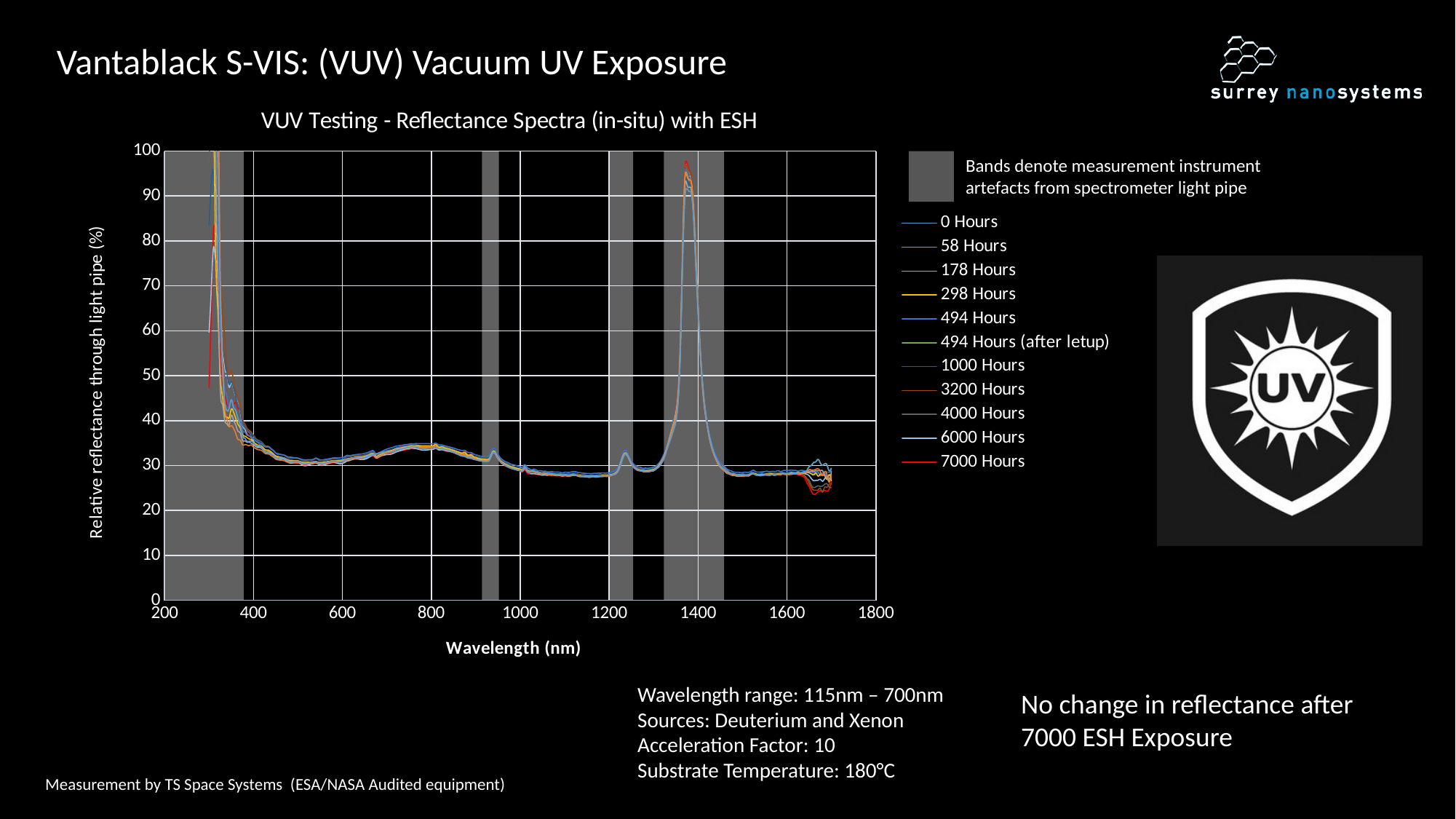
Is the peak reflectance value near 1400 nm greater or less than 80? greater Do the reflectance values rise or fall as wavelength increases from 1300 nm to 1380 nm? rise Do the reflectance values rise or fall as wavelength increases from 300 nm to 400 nm? fall Is the reflectance value at 600 nm greater or less than 50? less What is the label of the x axis of the chart? Wavelength (nm) Is the reflectance value at 1000 nm greater or less than 40? less What kind of chart is shown on the slide? Line chart What is the highest value shown on the y axis of the chart? 100 What is the title of the chart? VUV Testing - Reflectance Spectra (in-situ) with ESH How many series does the chart legend list? 11 Which is larger, the reflectance at 1400 nm or the reflectance at 1000 nm? 1400 nm